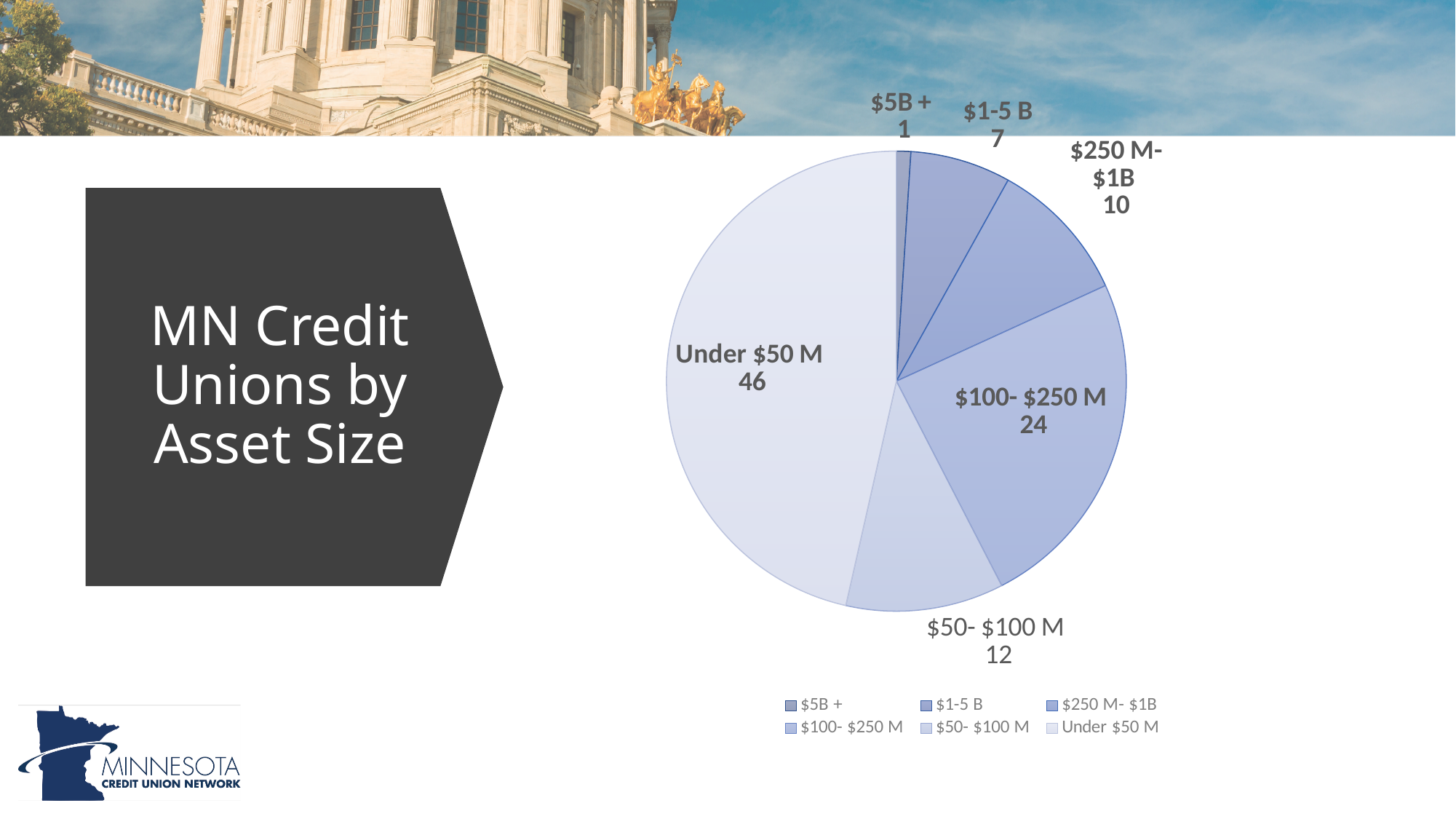
Which asset size category has the smallest slice? $5B + What is the value for the $100- $250 M slice? 24 What share of the pie does the Under $50 M slice represent? 46% What is the value for the $250 M- $1B slice? 10 How many slices does the pie chart have? 6 What kind of chart is shown on the slide? pie chart What is the difference between the Under $50 M value and the $100- $250 M value? 22 What is the value for the $5B + slice? 1 Which asset size category has the largest slice? Under $50 M Which is larger, the $50- $100 M slice or the $1-5 B slice? $50- $100 M What is the total of all the slice values in the pie chart? 100 How many credit unions are in the Under $50 M category? 46